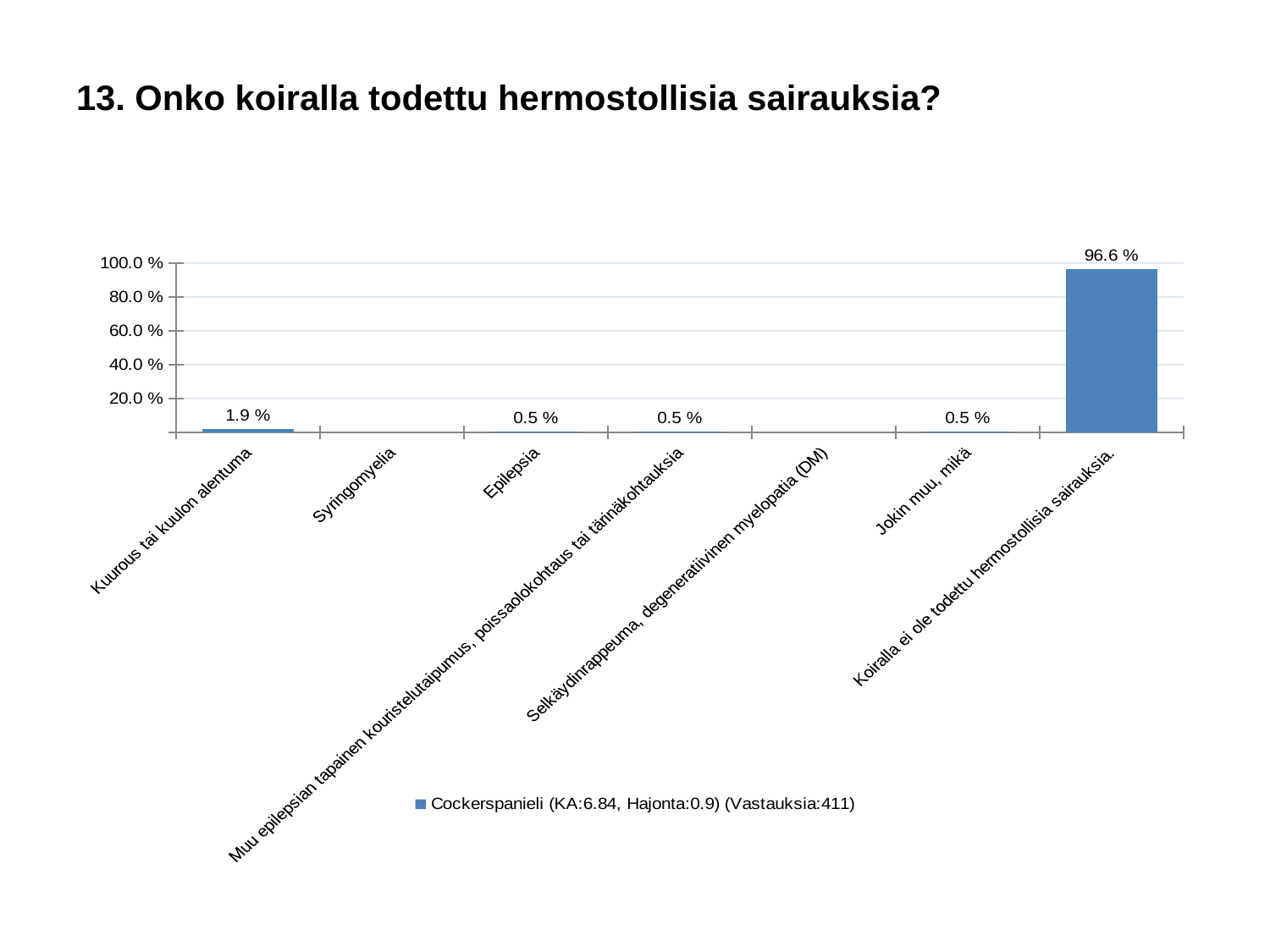
Which category has the highest value? Koiralla ei ole todettu hermostollisia sairauksia. What is the value for "Jokin muu, mikä"? 0.5 % What is the value for "Epilepsia"? 0.5 % What is the title of the slide? 13. Onko koiralla todettu hermostollisia sairauksia? What is the value for "Koiralla ei ole todettu hermostollisia sairauksia."? 96.6 % What kind of chart is shown on the slide? bar chart What is the difference between the values for "Koiralla ei ole todettu hermostollisia sairauksia." and "Kuurous tai kuulon alentuma"? 94.7 % Which is larger, the value for "Kuurous tai kuulon alentuma" or the value for "Epilepsia"? Kuurous tai kuulon alentuma How many series does the legend list? 1 How many categories are shown on the x axis? 7 Is the value for "Koiralla ei ole todettu hermostollisia sairauksia." greater or less than 80.0 %? greater What is the value for "Kuurous tai kuulon alentuma"? 1.9 %